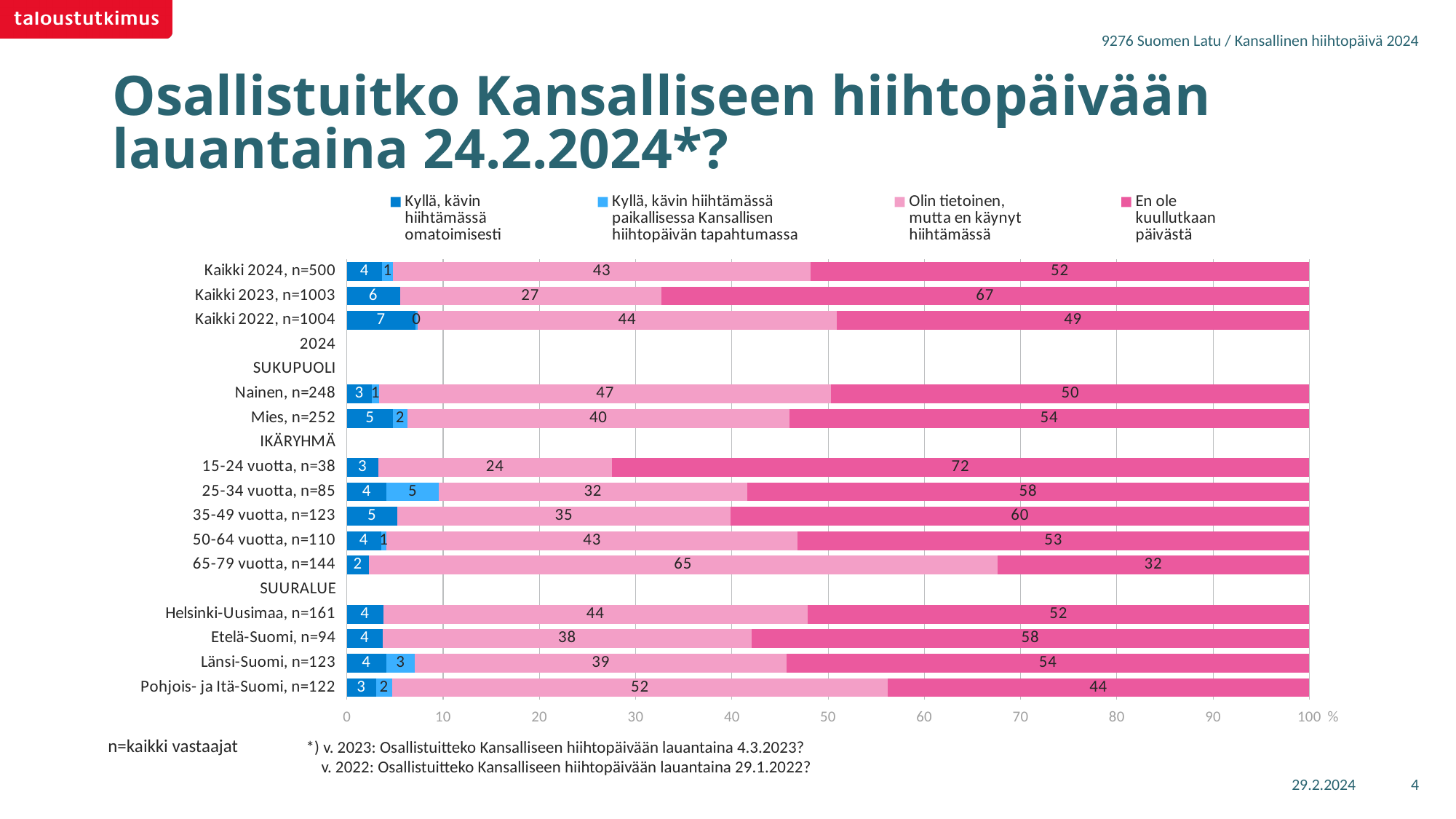
How many series does the legend list? 4 What is the value of "Kyllä, kävin hiihtämässä omatoimisesti" for Kaikki 2022, n=1004? 7 Which category has the lowest value for "Olin tietoinen, mutta en käynyt hiihtämässä"? 15-24 vuotta, n=38 Which category has the highest value for "En ole kuullutkaan päivästä"? 15-24 vuotta, n=38 How many categories have data bars plotted in the chart? 14 What colour represents the "En ole kuullutkaan päivästä" series? Dark pink Which has a larger value for "Olin tietoinen, mutta en käynyt hiihtämässä": Nainen, n=248 or Mies, n=252? Nainen, n=248 What is the difference between the "En ole kuullutkaan päivästä" values for Kaikki 2023, n=1003 and Kaikki 2024, n=500? 15 What is the value of "Olin tietoinen, mutta en käynyt hiihtämässä" for 65-79 vuotta, n=144? 65 What is the value of "En ole kuullutkaan päivästä" for Kaikki 2024, n=500? 52 What kind of chart is shown on the slide? Stacked bar chart What is the value of "Kyllä, kävin hiihtämässä paikallisessa Kansallisen hiihtopäivän tapahtumassa" for 25-34 vuotta, n=85? 5